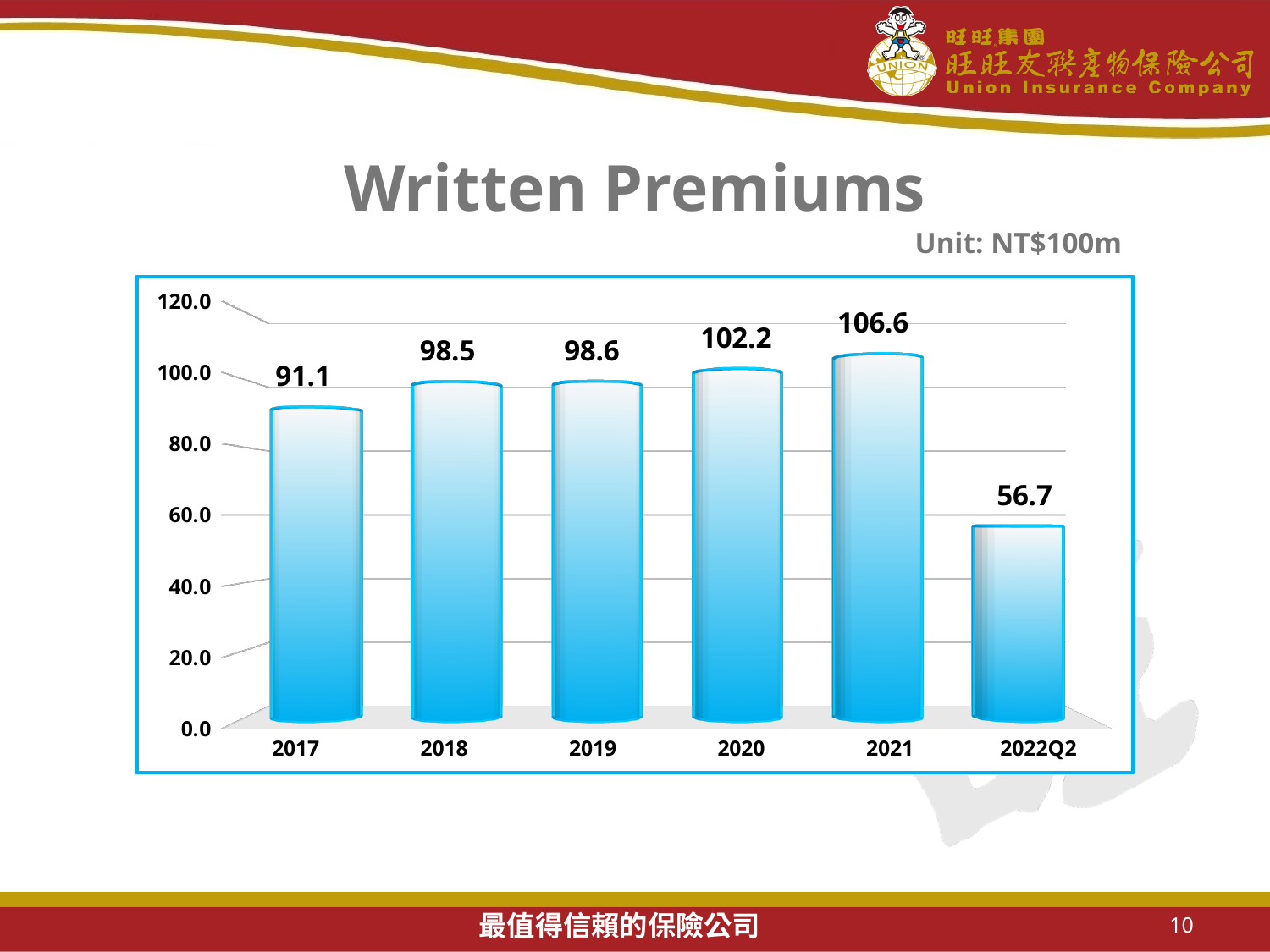
What is the written premium value for 2017? 91.1 What is the difference between the written premiums in 2021 and 2017? 15.5 What is the written premium value for 2020? 102.2 Which period has the lowest written premiums? 2022Q2 What is the written premium value for 2022Q2? 56.7 Which period has the highest written premiums? 2021 How many periods are shown on the x axis? 6 What kind of chart is shown on the slide? bar chart What is the difference between the written premiums in 2020 and 2019? 3.6 Which is larger, the written premiums for 2020 or for 2018? 2020 Is the value for 2022Q2 greater or less than 60.0? less What unit is stated for the chart values? NT$100m